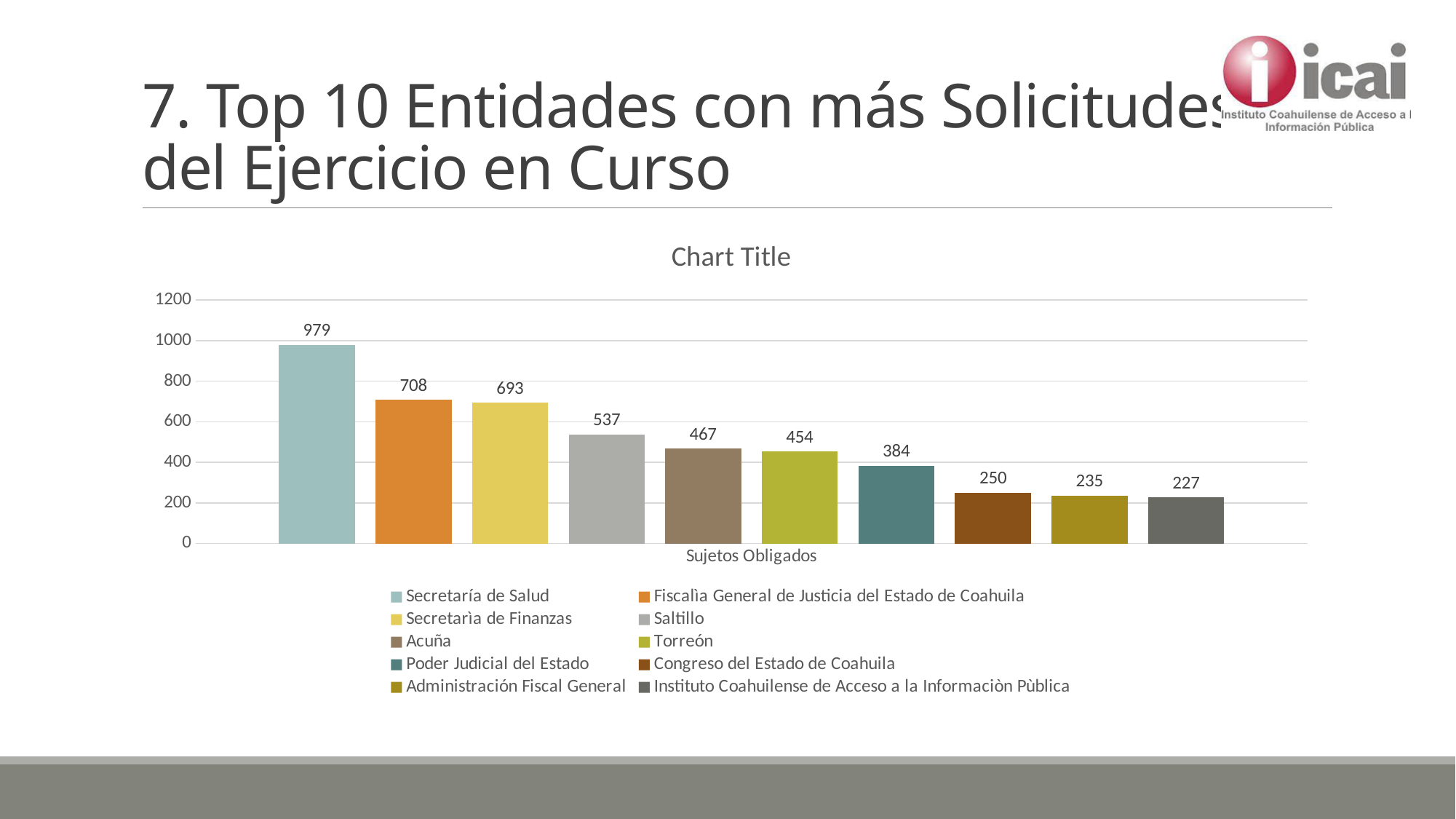
Which is larger, the value for Acuña or the value for Torreón? Acuña Which entity has the lowest value? Instituto Coahuilense de Acceso a la Informaciòn Pùblica Which entity has the highest value? Secretaría de Salud What kind of chart is shown on the slide? Bar chart What is the value for Instituto Coahuilense de Acceso a la Informaciòn Pùblica? 227 What is the value for Poder Judicial del Estado? 384 What is the x-axis label of the chart? Sujetos Obligados How many series does the legend list? 10 What is the difference between the values for Secretaría de Salud and Fiscalìa General de Justicia del Estado de Coahuila? 271 What is the value for Saltillo? 537 Is the value for Secretarìa de Finanzas greater or less than 600? greater What is the value for Secretaría de Salud? 979